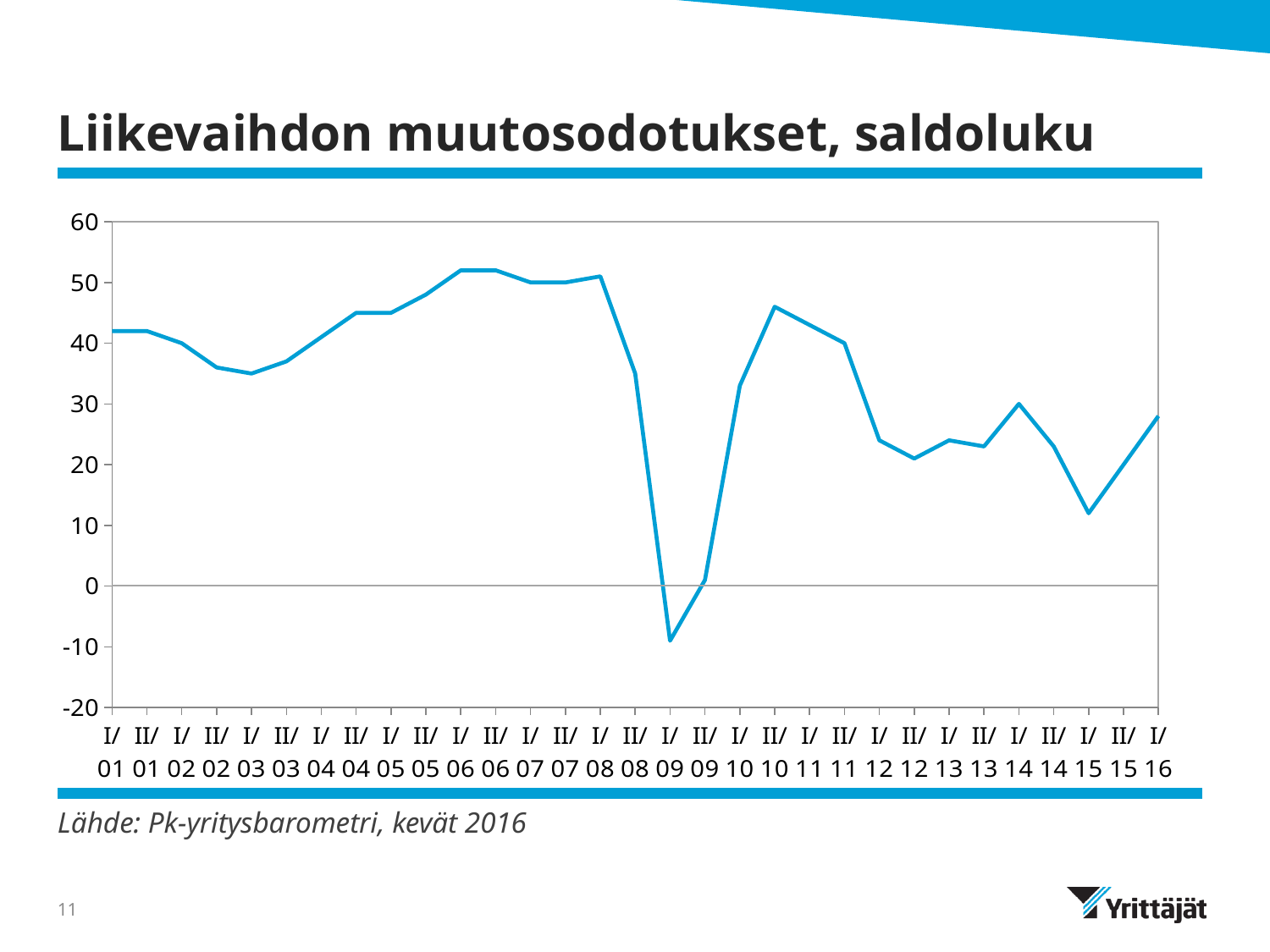
Which is larger, the value for I/09 or the value for II/09? II/09 What is the title of the chart? Liikevaihdon muutosodotukset, saldoluku Is the value for I/10 greater or less than 40? less Is the value for I/12 greater or less than 30? less Is the value for I/01 greater or less than 40? greater Which is larger, the value for I/01 or the value for I/16? I/01 Which period has the lowest value on the chart? I/09 Do the values rise or fall from I/08 to I/09? fall What kind of chart is shown on the slide? line chart How many data points are plotted on the line? 31